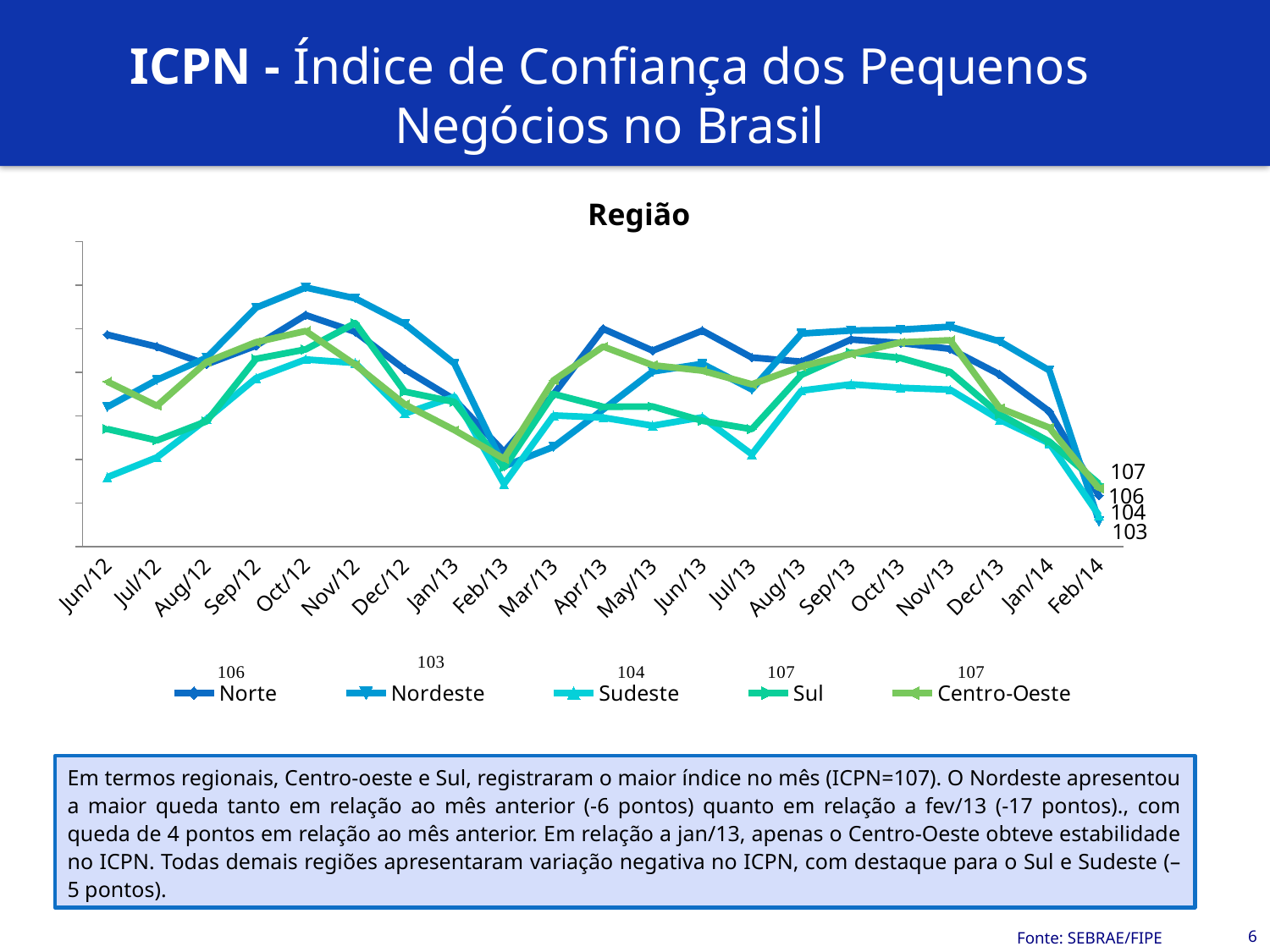
How many series does the legend of the chart list? 5 In Feb/14, which is larger, the value for Norte or the value for Sudeste? Norte What is the value for Sudeste in Feb/14? 104 What kind of chart is shown on the slide? Line chart Does the Nordeste line rise or fall from Nov/13 to Feb/14? Fall How many months are shown along the x axis of the chart? 21 Which region has the lowest value in Feb/14? Nordeste What is the value for Norte in Feb/14? 106 What is the value for Sul in Feb/14? 107 What is the difference between the Sul and Nordeste values in Feb/14? 4 Which region has the highest value in Oct/12? Nordeste What is the value for Nordeste in Feb/14? 103